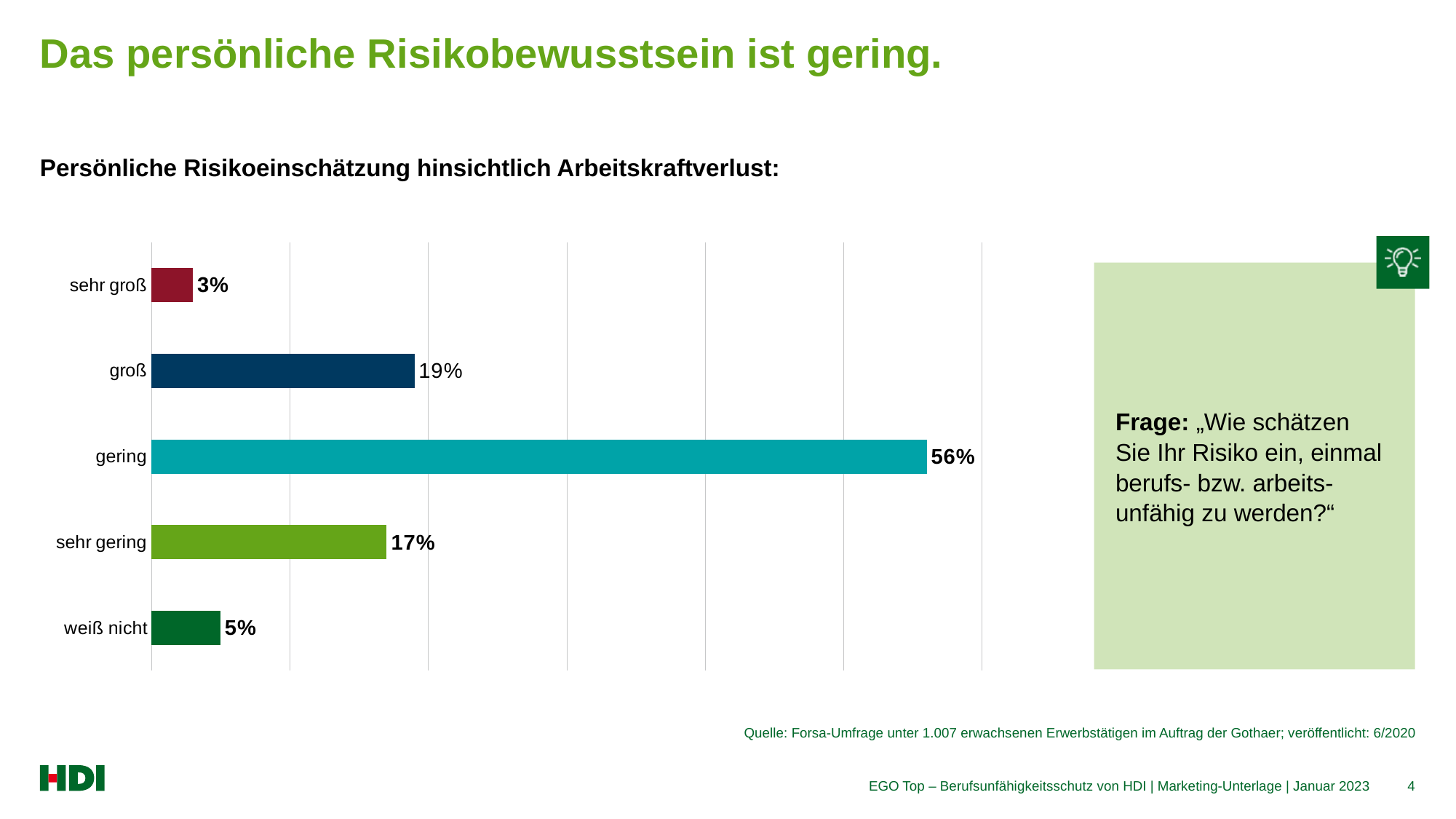
What colour is the bar for "gering"? teal How many categories are shown in the chart? 5 Which category has the lowest value? sehr groß What is the value for "groß"? 19% What is the value for "sehr gering"? 17% What is the value for "sehr groß"? 3% What is the difference between the values for "gering" and "groß"? 37% Which is larger, the value for "groß" or the value for "sehr gering"? groß Which category has the highest value? gering What kind of chart is shown on the slide? bar chart What is the value for "weiß nicht"? 5% What is the value for "gering"? 56%